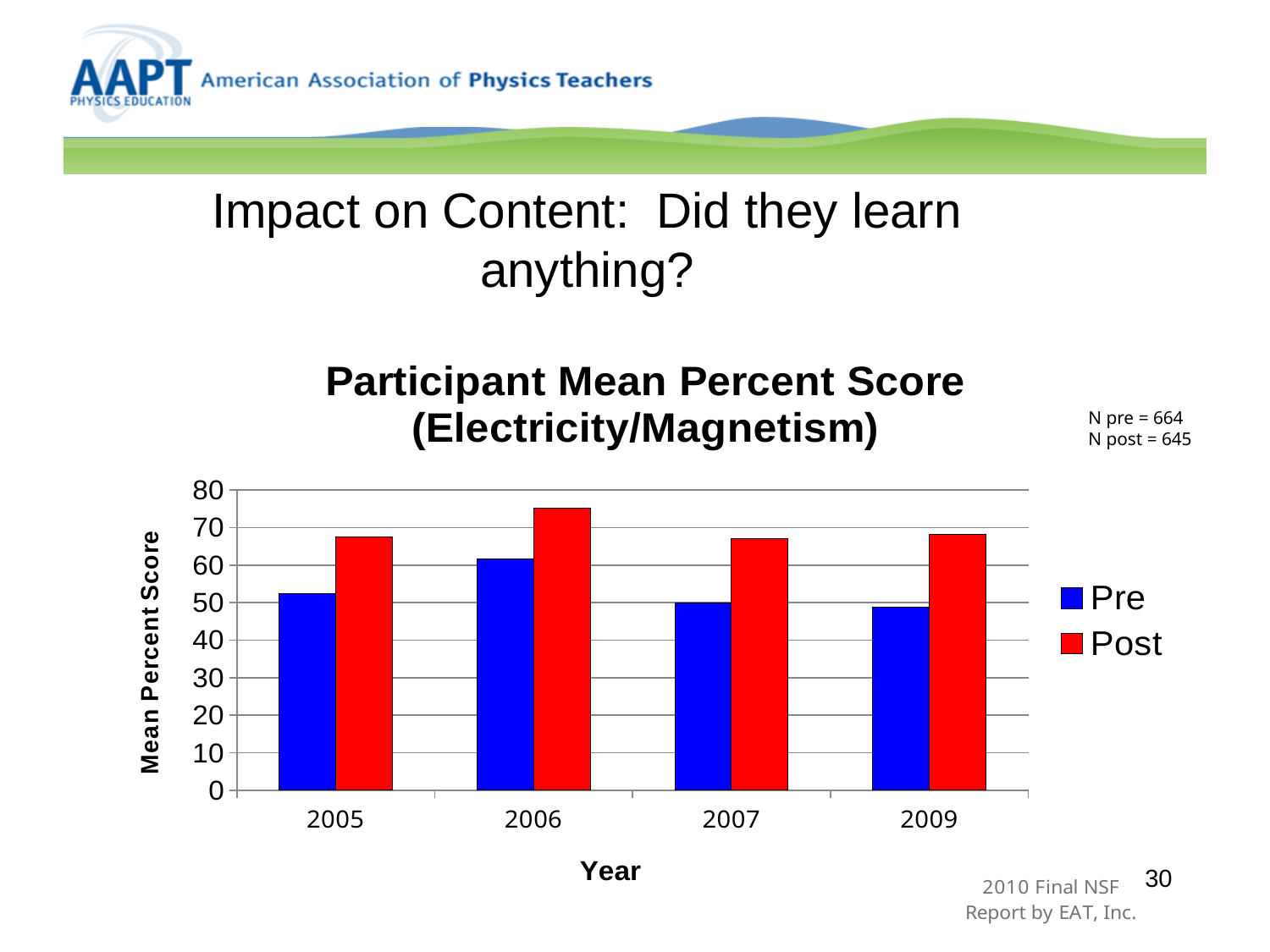
Is the Pre value for 2006 greater or less than 50? greater What kind of chart is shown on the slide? bar chart Is the Pre value for 2007 greater or less than 60? less Which is larger, the Pre score for 2006 or the Pre score for 2005? 2006 In 2007, which is larger, the Pre score or the Post score? Post How many series does the legend list? 2 Which year has the highest Post score? 2006 Which year has the highest Pre score? 2006 How many years are shown on the x axis? 4 Is the Post value for 2009 greater or less than 60? greater What is the title of the chart? Participant Mean Percent Score (Electricity/Magnetism)